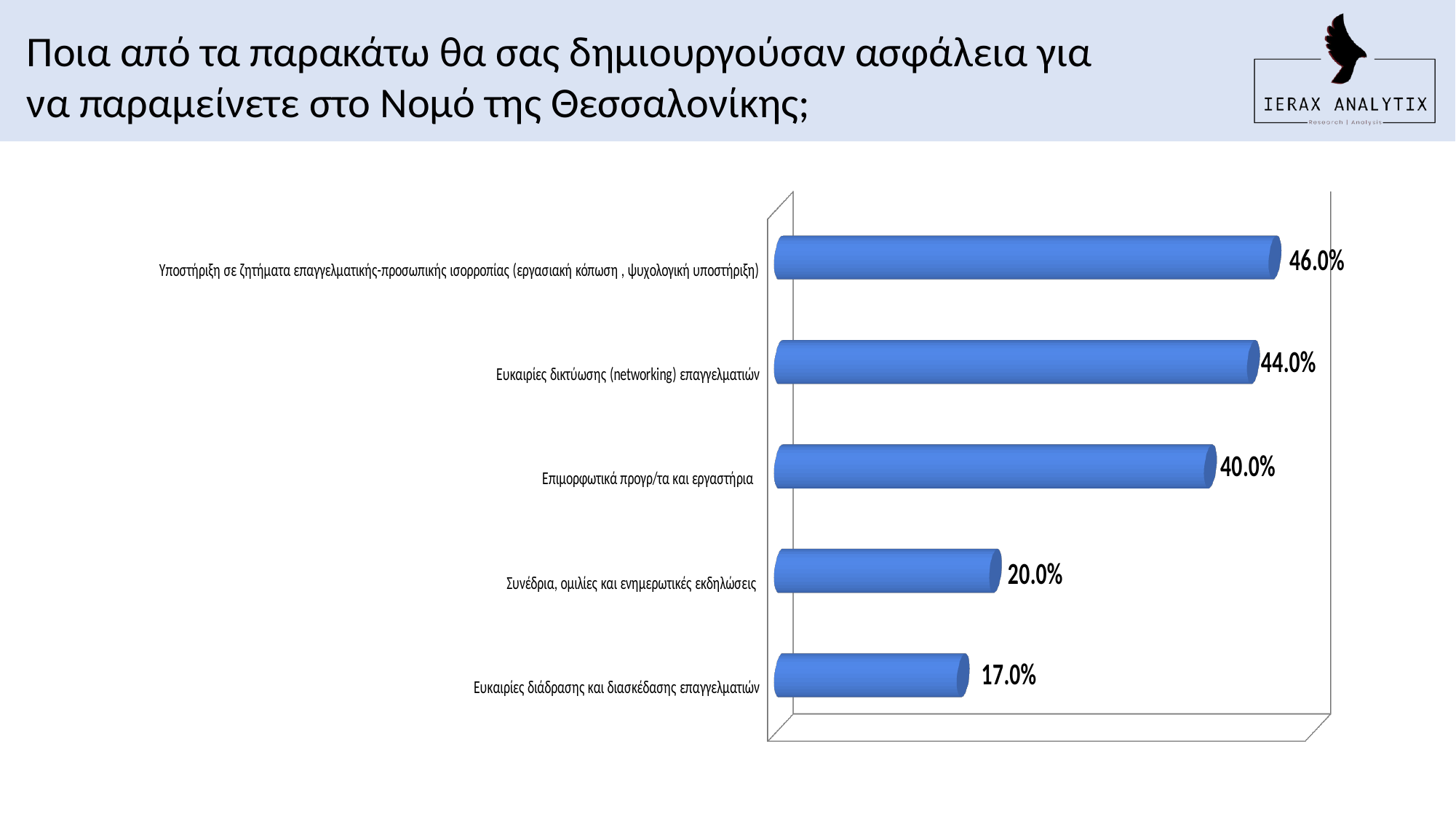
What is the value for 'Ευκαιρίες διάδρασης και διασκέδασης επαγγελματιών'? 17.0% What is the value for 'Συνέδρια, ομιλίες και ενημερωτικές εκδηλώσεις'? 20.0% Which category has the highest value? Υποστήριξη σε ζητήματα επαγγελματικής-προσωπικής ισορροπίας (εργασιακή κόπωση , ψυχολογική υποστήριξη) What is the value for 'Ευκαιρίες δικτύωσης (networking) επαγγελματιών'? 44.0% What kind of chart is shown on the slide? Bar chart Which category has the lowest value? Ευκαιρίες διάδρασης και διασκέδασης επαγγελματιών What is the value for 'Επιμορφωτικά προγρ/τα και εργαστήρια'? 40.0% How many categories are shown in the chart? 5 What is the difference between the values for 'Υποστήριξη σε ζητήματα επαγγελματικής-προσωπικής ισορροπίας' and 'Ευκαιρίες δικτύωσης (networking) επαγγελματιών'? 2.0% Which is larger: the value for 'Συνέδρια, ομιλίες και ενημερωτικές εκδηλώσεις' or for 'Ευκαιρίες διάδρασης και διασκέδασης επαγγελματιών'? Συνέδρια, ομιλίες και ενημερωτικές εκδηλώσεις What is the difference between the values for 'Επιμορφωτικά προγρ/τα και εργαστήρια' and 'Συνέδρια, ομιλίες και ενημερωτικές εκδηλώσεις'? 20.0% What colour are the bars in the chart? Blue